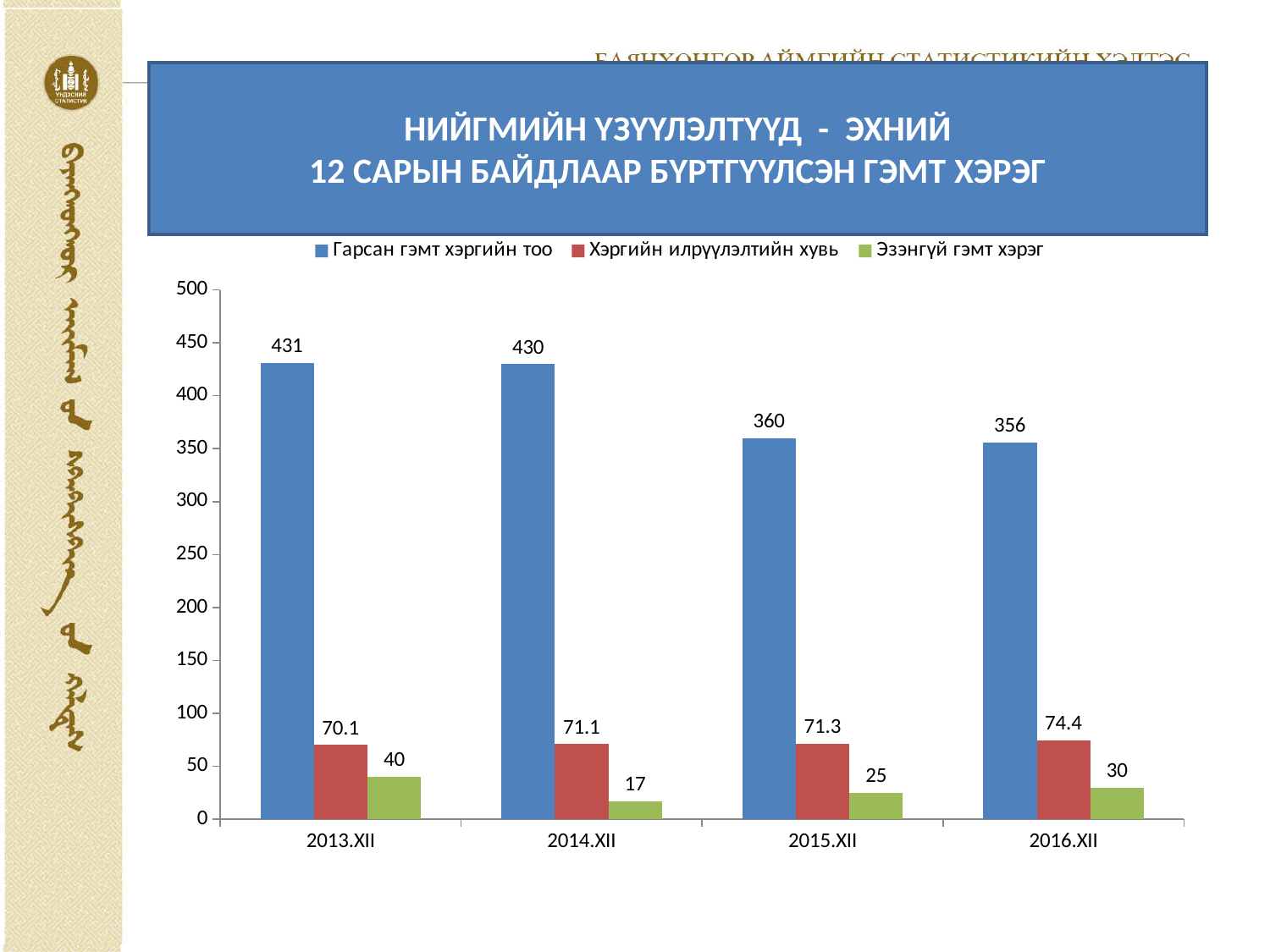
What is the value of Гарсан гэмт хэргийн тоо for 2013.XII? 431 What is the value of Хэргийн илрүүлэлтийн хувь for 2016.XII? 74.4 In which period is Гарсан гэмт хэргийн тоо the lowest? 2016.XII What is the value of Эзэнгүй гэмт хэрэг for 2014.XII? 17 What kind of chart is shown on the slide? bar chart What is the difference between Гарсан гэмт хэргийн тоо in 2013.XII and 2016.XII? 75 Is the value of Гарсан гэмт хэргийн тоо for 2015.XII greater or less than 400? less How many series does the legend list? 3 How many periods are shown on the x axis? 4 Which is larger: Эзэнгүй гэмт хэрэг in 2015.XII or in 2016.XII? 2016.XII Does Хэргийн илрүүлэлтийн хувь rise or fall from 2013.XII to 2016.XII? rise In which period is Эзэнгүй гэмт хэрэг the highest? 2013.XII